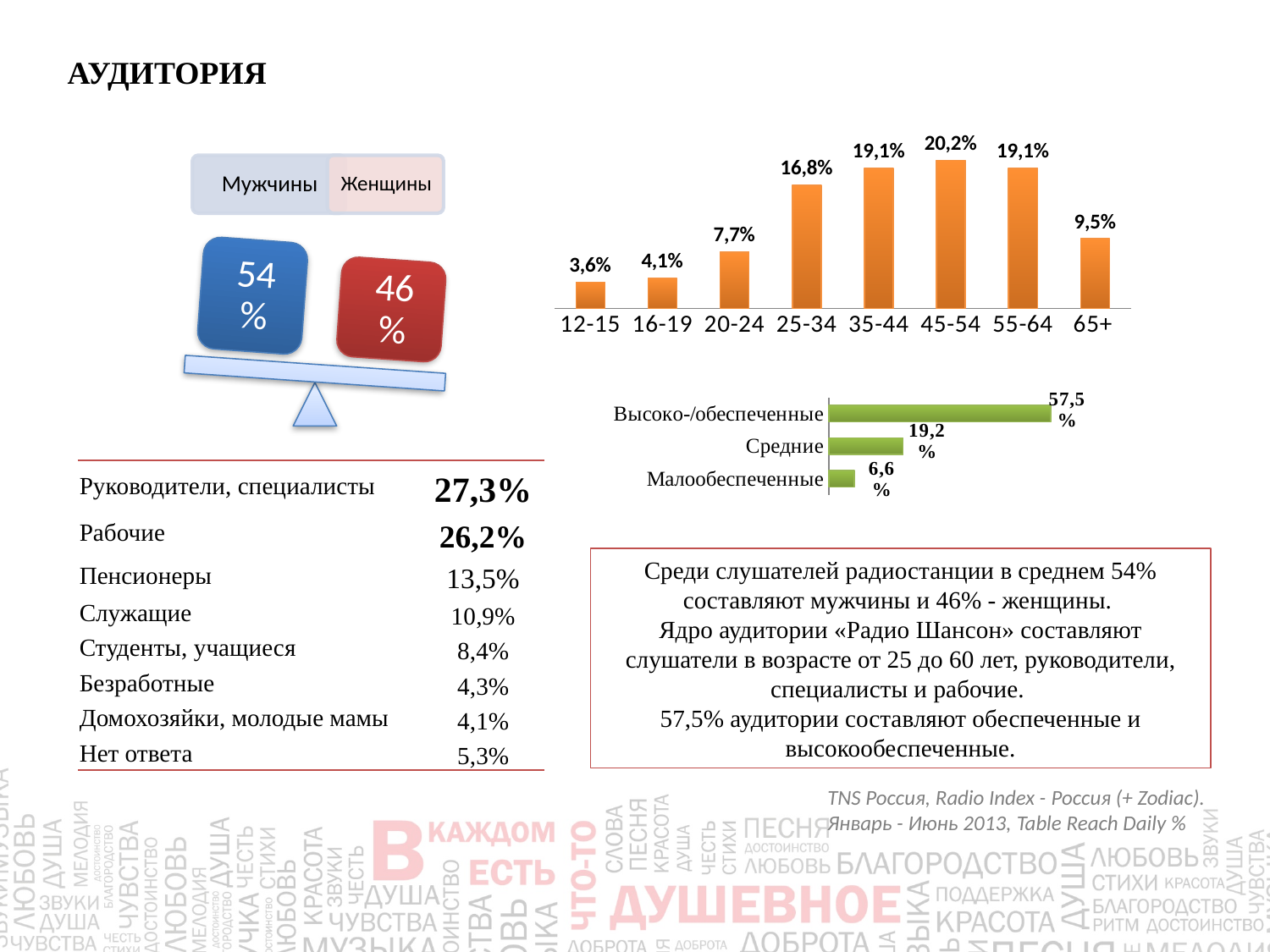
How many age groups are shown in the age-group bar chart at the top right? 8 In the age-group bar chart at the top right, which is larger: the value for 65+ or the value for 20-24? 65+ In the age-group bar chart at the top right, do the values rise or fall from 12-15 to 45-54? rise In the age-group bar chart at the top right, what is the value for the 45-54 age group? 20,2% In the income-level bar chart in the middle right, which category has the highest value? Высоко-/обеспеченные In the age-group bar chart at the top right, what is the difference between the values for 25-34 and 20-24? 9,1% In the age-group bar chart at the top right, which age group has the highest value? 45-54 What kind of chart is the income-level chart in the middle right of the slide? bar chart In the age-group bar chart at the top right, what is the value for the 12-15 age group? 3,6% In the income-level bar chart in the middle right, what is the value for Средние? 19,2% In the age-group bar chart at the top right, which age group has the lowest value? 12-15 In the income-level bar chart in the middle right, what is the difference between the values for Высоко-/обеспеченные and Малообеспеченные? 50,9%